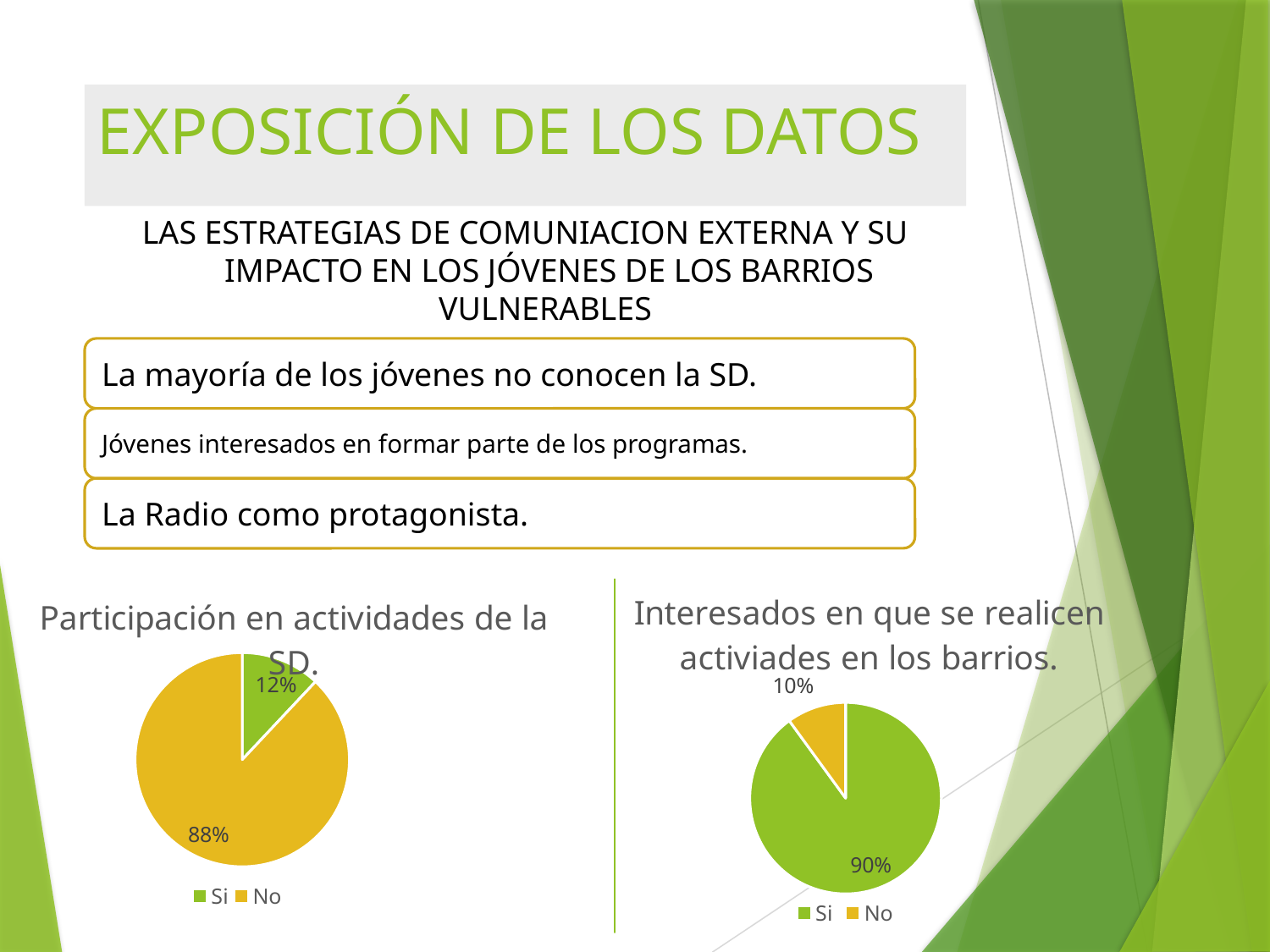
How many categories does the legend of the right chart, "Interesados en que se realicen actividades en los barrios.", list? 2 In the chart titled "Interesados en que se realicen actividades en los barrios.", what percentage is shown for "Si"? 90% In the left chart, "Participación en actividades de la SD.", which category has the largest slice? No In the left chart, "Participación en actividades de la SD.", what is the difference between the "No" and "Si" percentages? 76% In the right chart, "Interesados en que se realicen actividades en los barrios.", what is the difference between the "Si" and "No" percentages? 80% What type of chart is used for "Participación en actividades de la SD."? Pie chart In the right chart, "Interesados en que se realicen actividades en los barrios.", which category has the smallest slice? No In the left chart, "Participación en actividades de la SD.", what colour represents "No"? Yellow In the chart titled "Participación en actividades de la SD.", what percentage is shown for "No"? 88% In the chart titled "Interesados en que se realicen actividades en los barrios.", what percentage is shown for "No"? 10% In the chart titled "Participación en actividades de la SD.", what percentage is shown for "Si"? 12% Which is larger: "Si" in the left chart (Participación en actividades de la SD.) or "Si" in the right chart (Interesados en que se realicen actividades en los barrios.)? Si in the right chart